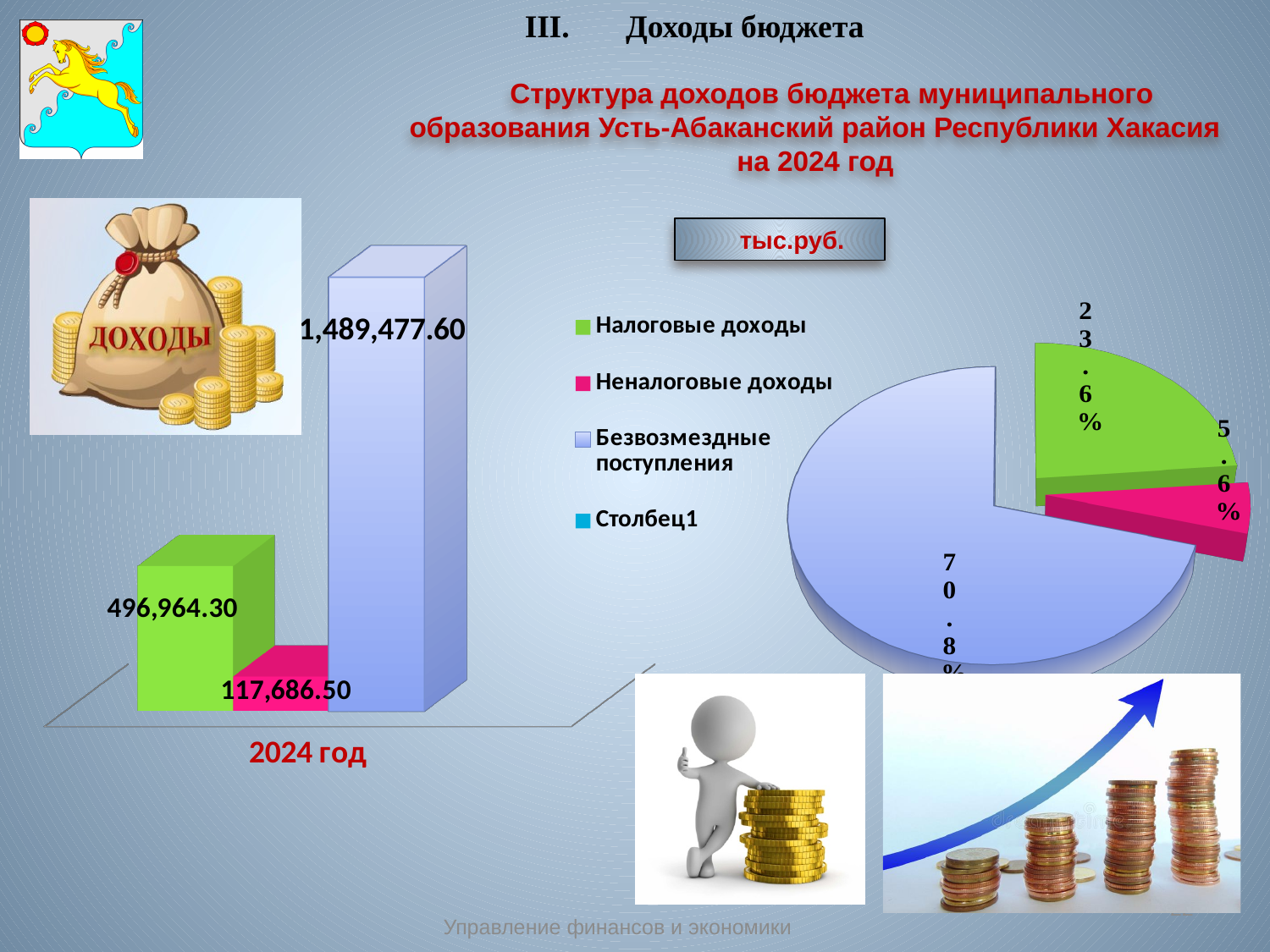
On the bar chart, what is the difference between Налоговые доходы and Неналоговые доходы? 379,277.80 On the bar chart, which is larger: Налоговые доходы or Неналоговые доходы? Налоговые доходы What kind of chart is shown on the left side of the slide? Bar chart On the pie chart, what share does the green slice (Налоговые доходы) represent? 23.6% How many entries does the legend list? 4 On the bar chart, which category has the lowest value? Неналоговые доходы On the bar chart, what is the value for Налоговые доходы? 496,964.30 On the bar chart, what is the value for Безвозмездные поступления? 1,489,477.60 On the bar chart, which category has the highest value? Безвозмездные поступления On the pie chart, what share does the largest slice (Безвозмездные поступления) represent? 70.8% On the bar chart, what is the value for Неналоговые доходы? 117,686.50 On the bar chart, what is the difference between Безвозмездные поступления and Налоговые доходы? 992,513.30